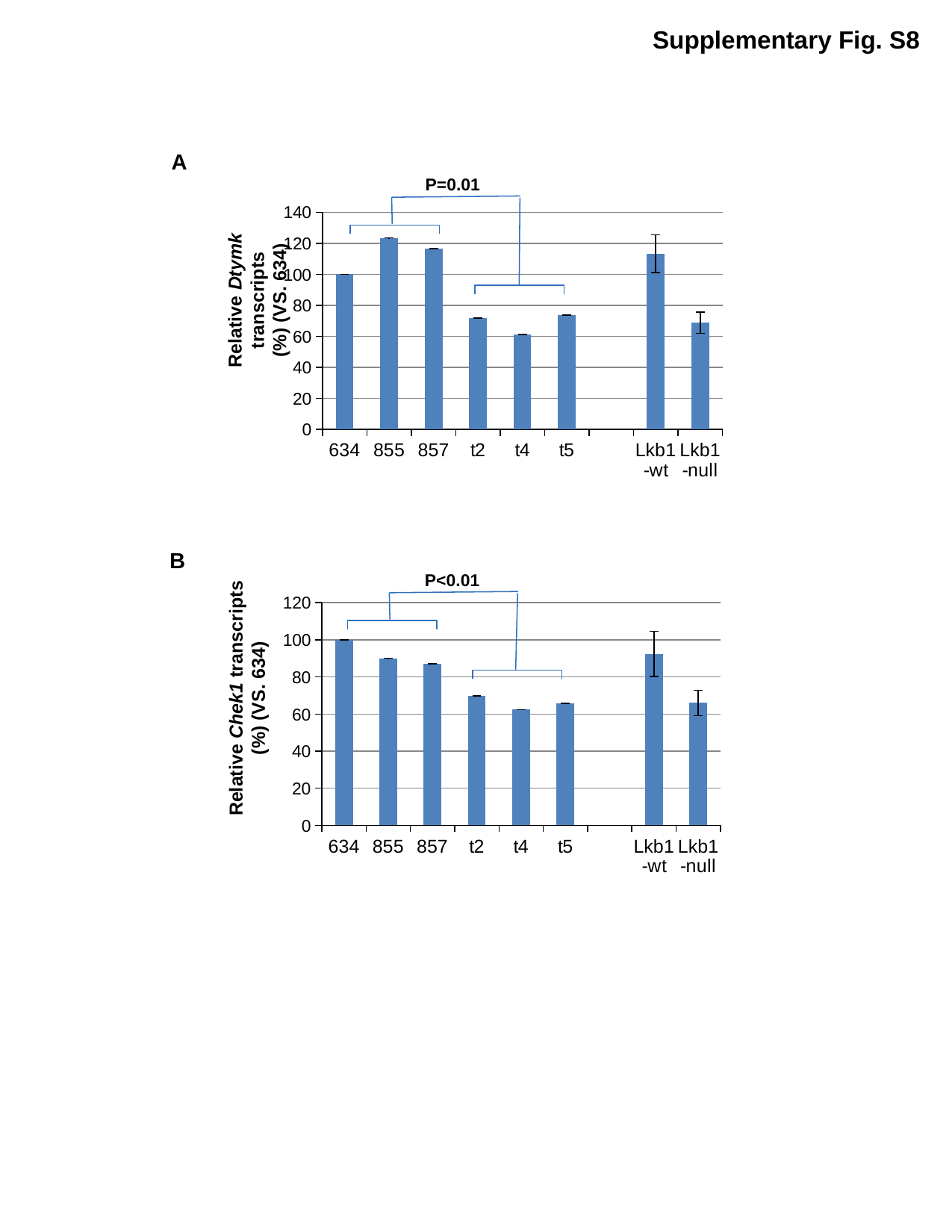
What P value is annotated above chart B? P<0.01 In chart B, is the value for 855 greater or less than 80? greater In chart A, which category has the lowest value? t4 In chart A, which is larger, the value for Lkb1-wt or the value for Lkb1-null? Lkb1-wt What is the y-axis label of chart A? Relative Dtymk transcripts (%) (VS. 634) In chart B, which category has the lowest value? t4 In chart A, what is the value for 634? 100 How many bars are plotted in chart B? 8 What kind of chart is chart A? bar chart In chart A, which category has the highest value? 855 In chart A, is the value for t2 greater or less than 80? less In chart B, what is the value for 634? 100